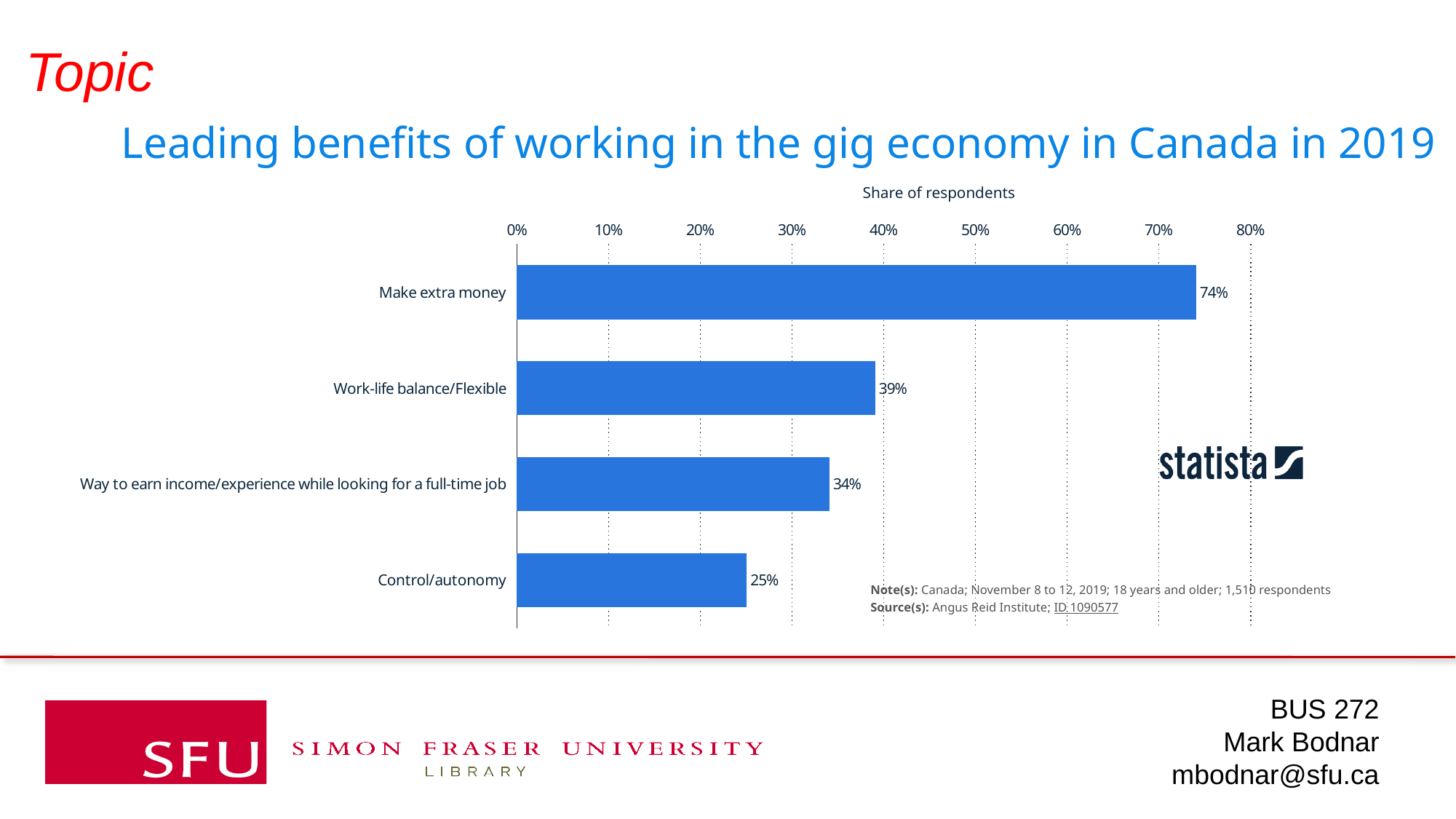
What is the value for "Way to earn income/experience while looking for a full-time job"? 34% What is the difference in percentage points between "Make extra money" and "Work-life balance/Flexible"? 35 percentage points What kind of chart is shown on the slide? Bar chart Is the value for "Control/autonomy" greater or less than 30%? less What is the title of the chart? Leading benefits of working in the gig economy in Canada in 2019 What share of respondents cited "Make extra money" as a benefit of working in the gig economy? 74% What is the value for "Work-life balance/Flexible"? 39% What share of respondents cited "Control/autonomy"? 25% Which benefit has the highest share of respondents? Make extra money Which benefit has the lowest share of respondents? Control/autonomy Which is larger: the value for "Work-life balance/Flexible" or for "Way to earn income/experience while looking for a full-time job"? Work-life balance/Flexible How many benefit categories are shown in the chart? 4